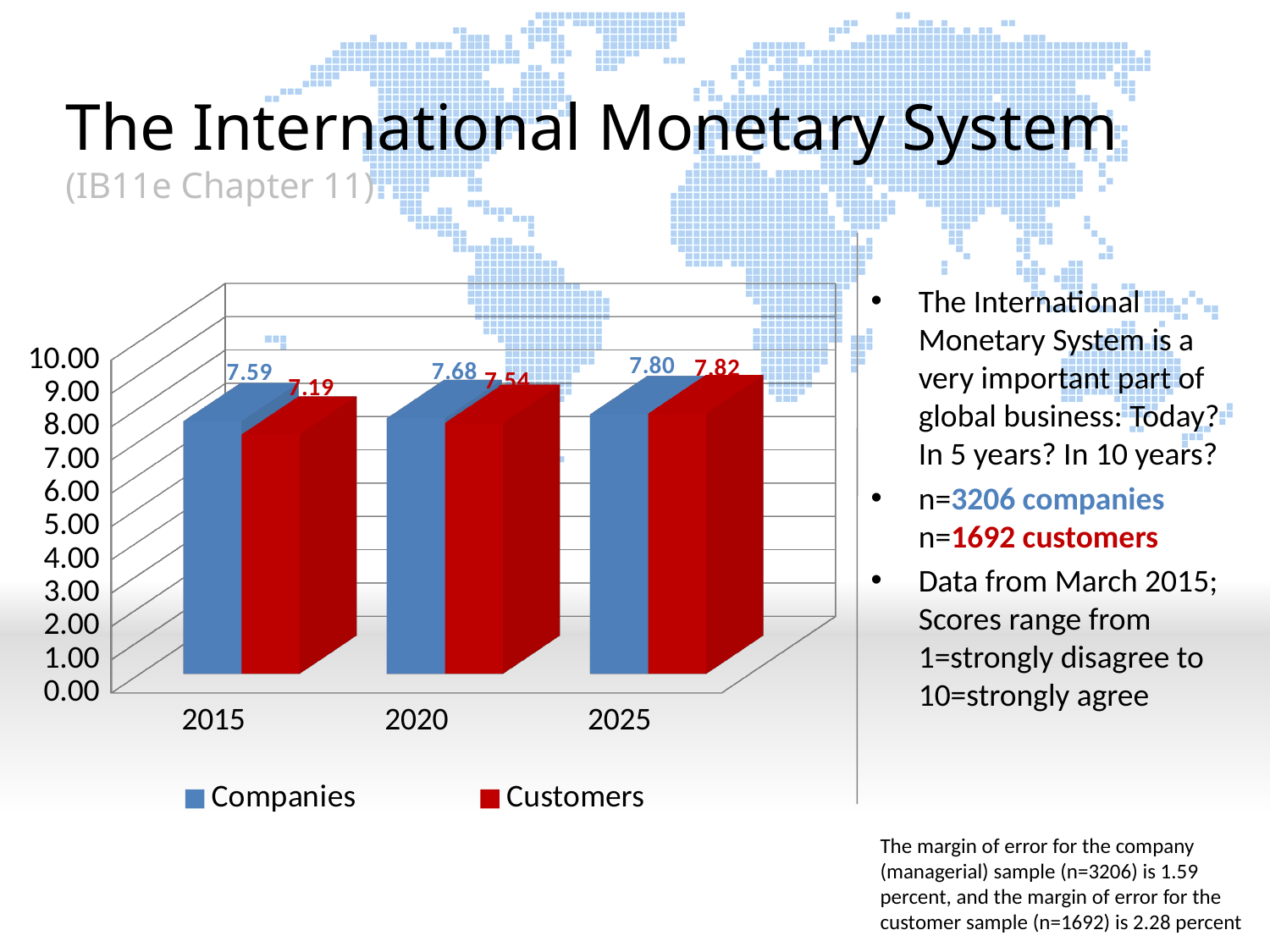
In 2015, which series has the larger value, Companies or Customers? Companies How many series does the legend list? 2 What is the value for Companies in 2020? 7.68 What is the difference between the Companies and Customers values in 2015? 0.40 In which year is the Customers value lowest? 2015 What is the value for Customers in 2025? 7.82 In which year is the Companies value highest? 2025 What is the value for Companies in 2025? 7.80 Do the Companies values rise or fall from 2015 to 2025? rise What is the value for Customers in 2015? 7.19 What is the value for Companies in 2015? 7.59 How many years are shown on the x axis? 3